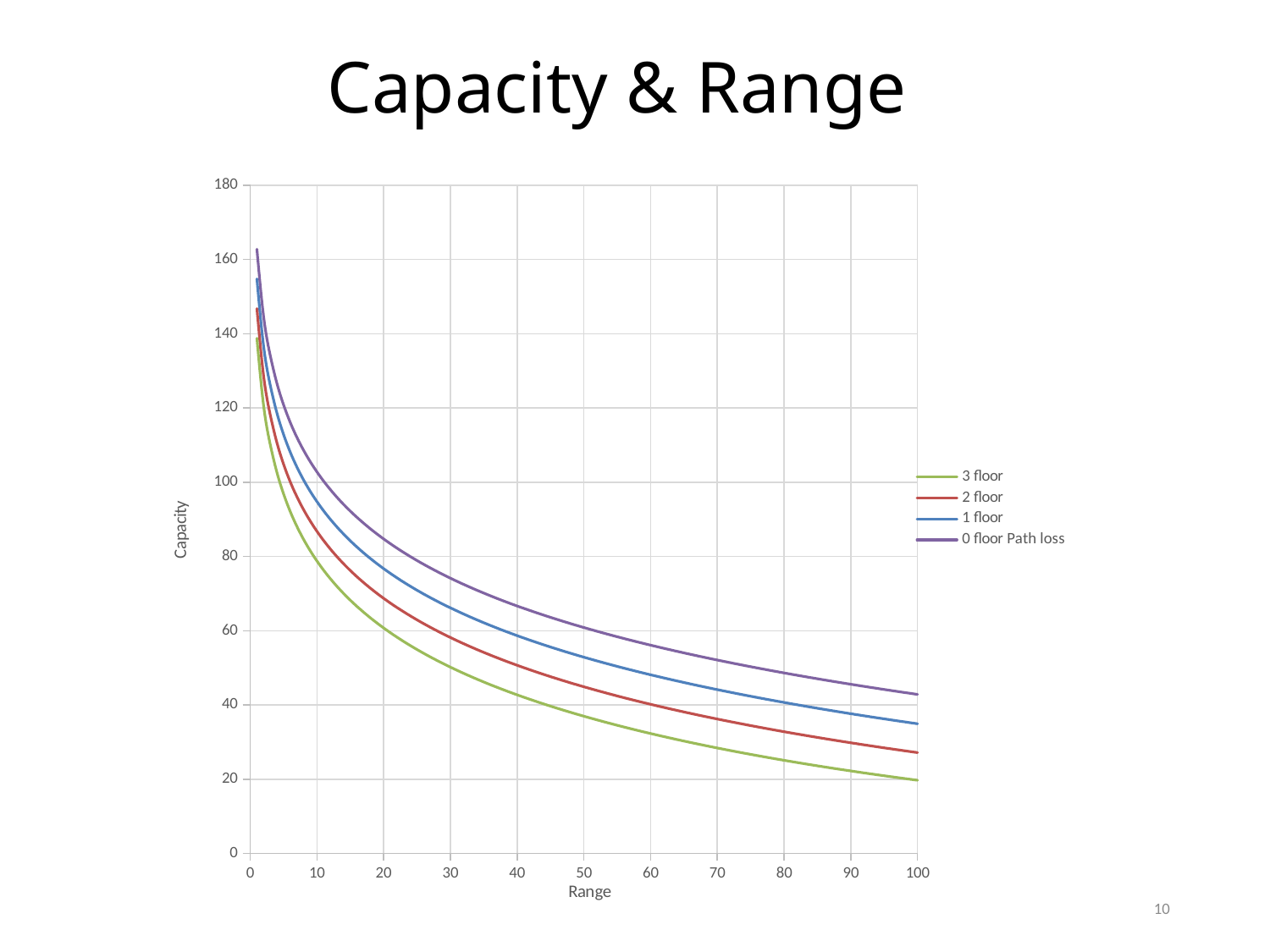
At a range of 50, which series has the larger capacity, 1 floor or 2 floor? 1 floor Which series has the lowest capacity at a range of 100? 3 floor What is the label of the vertical axis? Capacity At a range of 50, is the capacity for 3 floor greater or less than 40? less What kind of chart is shown on the slide? line chart At a range of 20, is the capacity for 0 floor Path loss greater or less than 80? greater At a range of 100, is the capacity for 0 floor Path loss greater or less than 40? greater How many series does the legend list? 4 Do the capacity values rise or fall as range increases along the x axis? fall What is the title of the chart? Capacity & Range Which series has the highest capacity at a range of 100? 0 floor Path loss